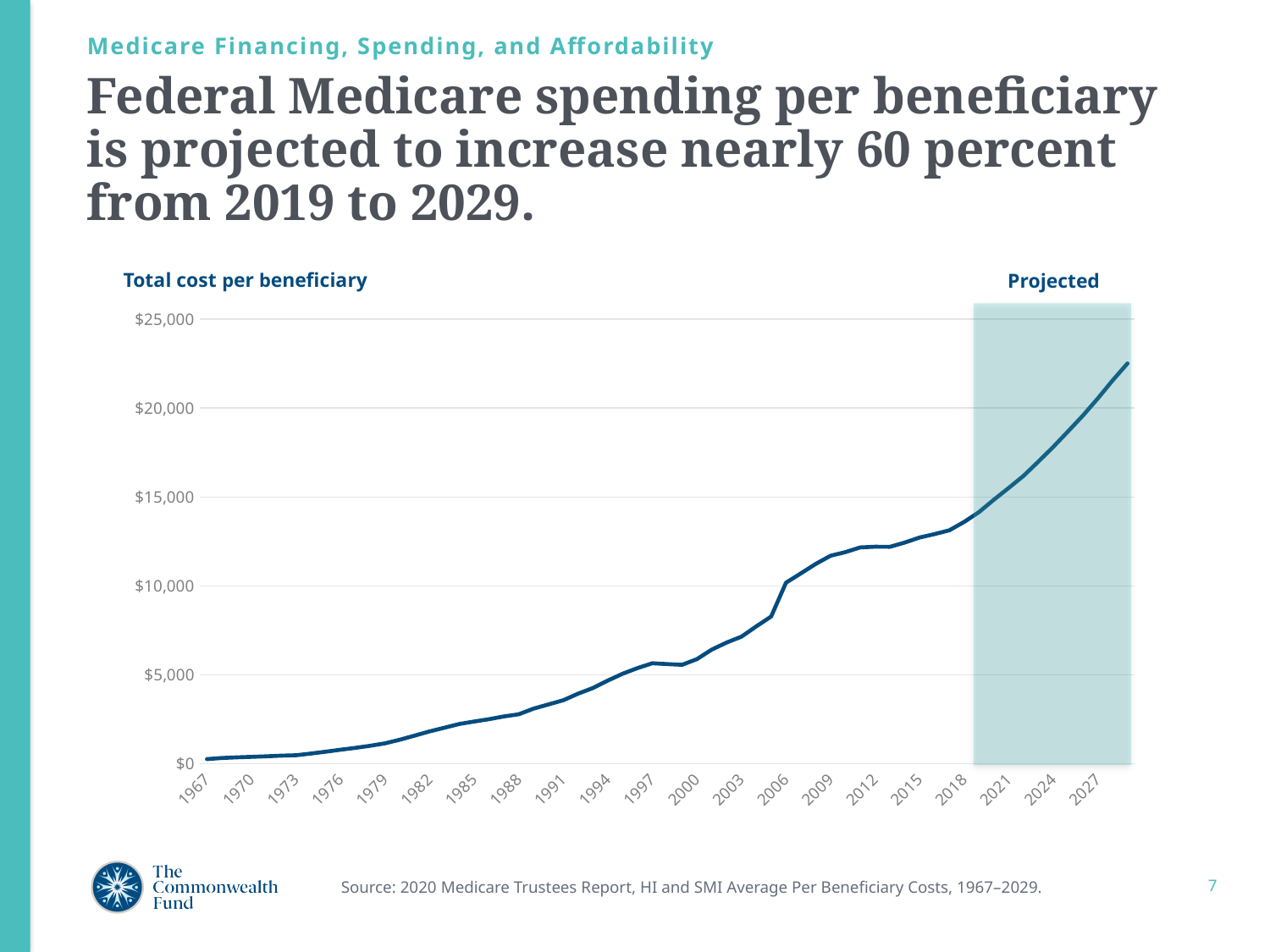
What label is shown above the shaded region on the right side of the chart? Projected Is the value for 2024 greater or less than $20,000? less Is the value for 2018 greater or less than $15,000? less In which year is the total cost per beneficiary lowest? 1967 Which is larger, the value for 2012 or the value for 2000? 2012 In which year is the total cost per beneficiary highest? 2029 Is the value for 2024 greater or less than $15,000? greater What kind of chart is shown on the slide? Line chart Do the values in the chart generally rise or fall from 1967 to 2029? Rise